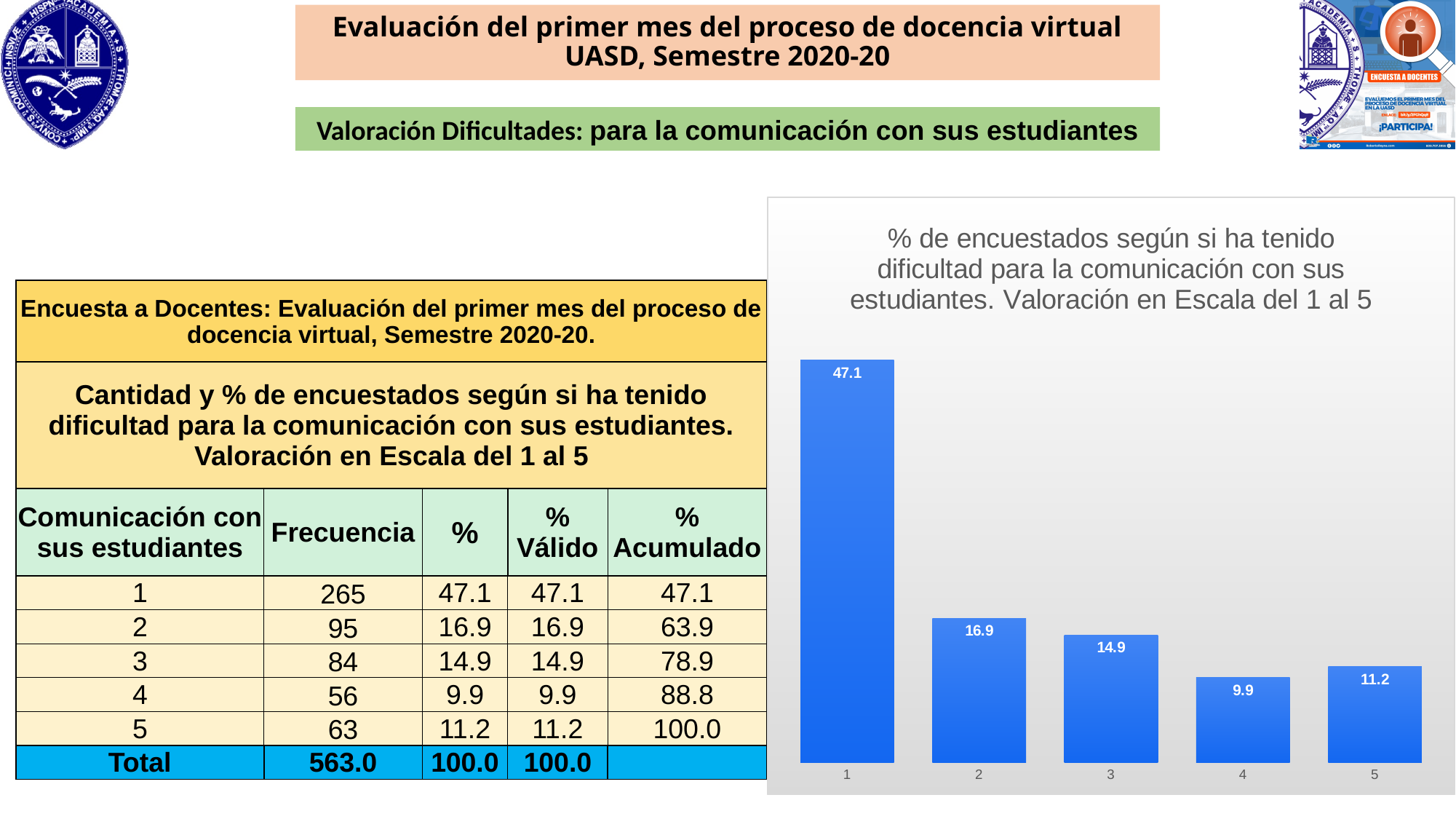
What is the value shown for category 5 in the bar chart? 11.2 Which has a larger value in the bar chart, category 2 or category 3? 2 What is the value shown for category 3 in the bar chart? 14.9 Which has a larger value in the bar chart, category 4 or category 5? 5 What is the difference between the values for category 1 and category 2 in the bar chart? 30.2 What is the difference between the values for category 5 and category 4 in the bar chart? 1.3 Which category has the highest value in the bar chart? 1 What is the value shown for category 1 in the bar chart? 47.1 What kind of chart is shown on the slide? bar chart What is the title of the chart on the slide? % de encuestados según si ha tenido dificultad para la comunicación con sus estudiantes. Valoración en Escala del 1 al 5 How many categories are shown on the x axis of the bar chart? 5 Which category has the lowest value in the bar chart? 4